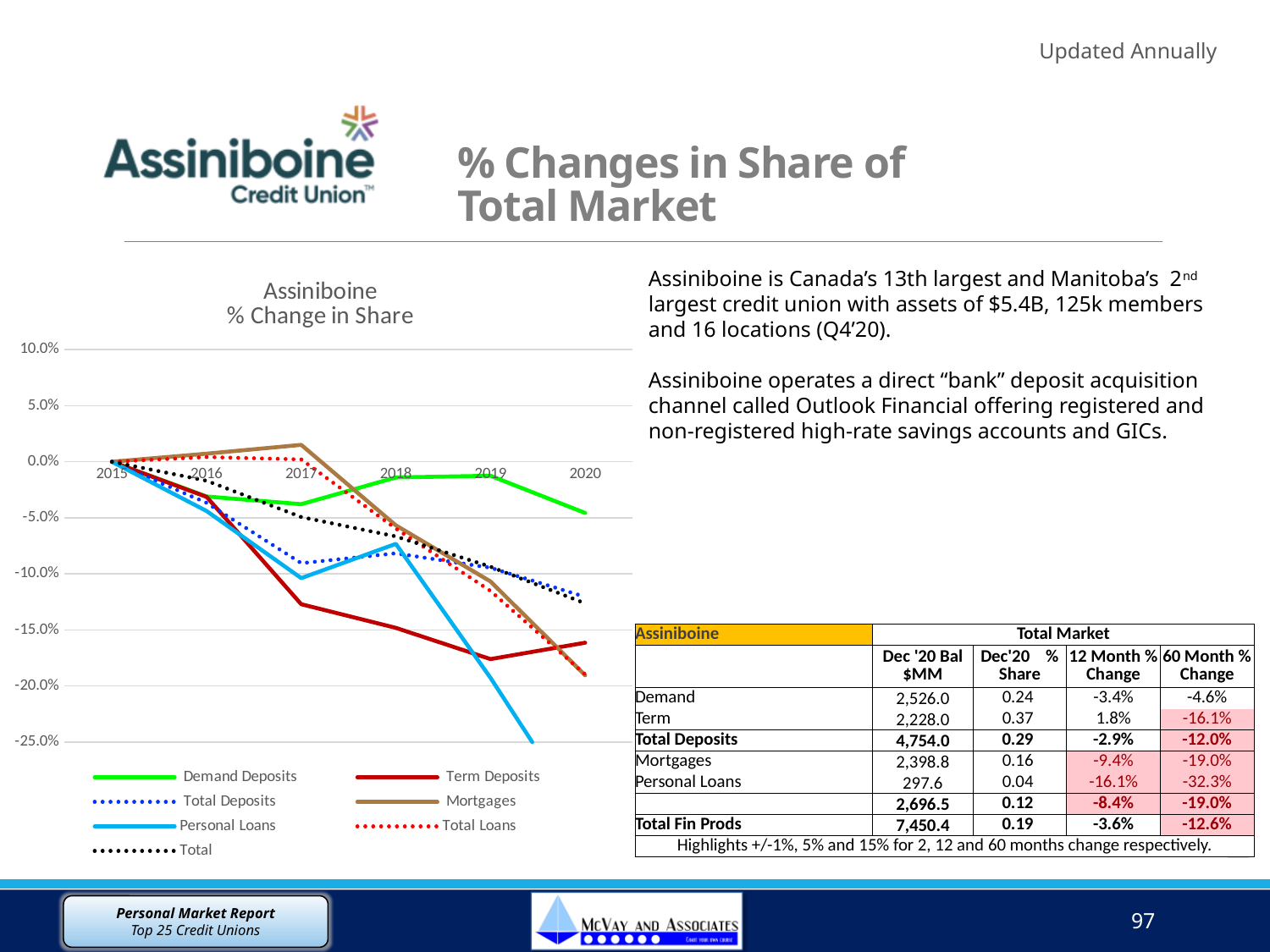
In 2020, which is larger: Demand Deposits or Term Deposits? Demand Deposits Which series has the highest value in 2020? Demand Deposits How many years are shown on the x axis of the chart? 6 Which series has the lowest value in 2020? Personal Loans Is the value for Mortgages in 2017 greater or less than 0.0%? greater How many series does the chart legend list? 7 What kind of chart is shown on the slide? line chart Which series in the chart is drawn in green? Demand Deposits Does the Personal Loans series rise or fall from 2015 to 2020? fall Is the value for Term Deposits in 2019 greater or less than -15.0%? less Is the value for Personal Loans in 2020 greater or less than -20.0%? less What is the title of the chart? Assiniboine % Change in Share